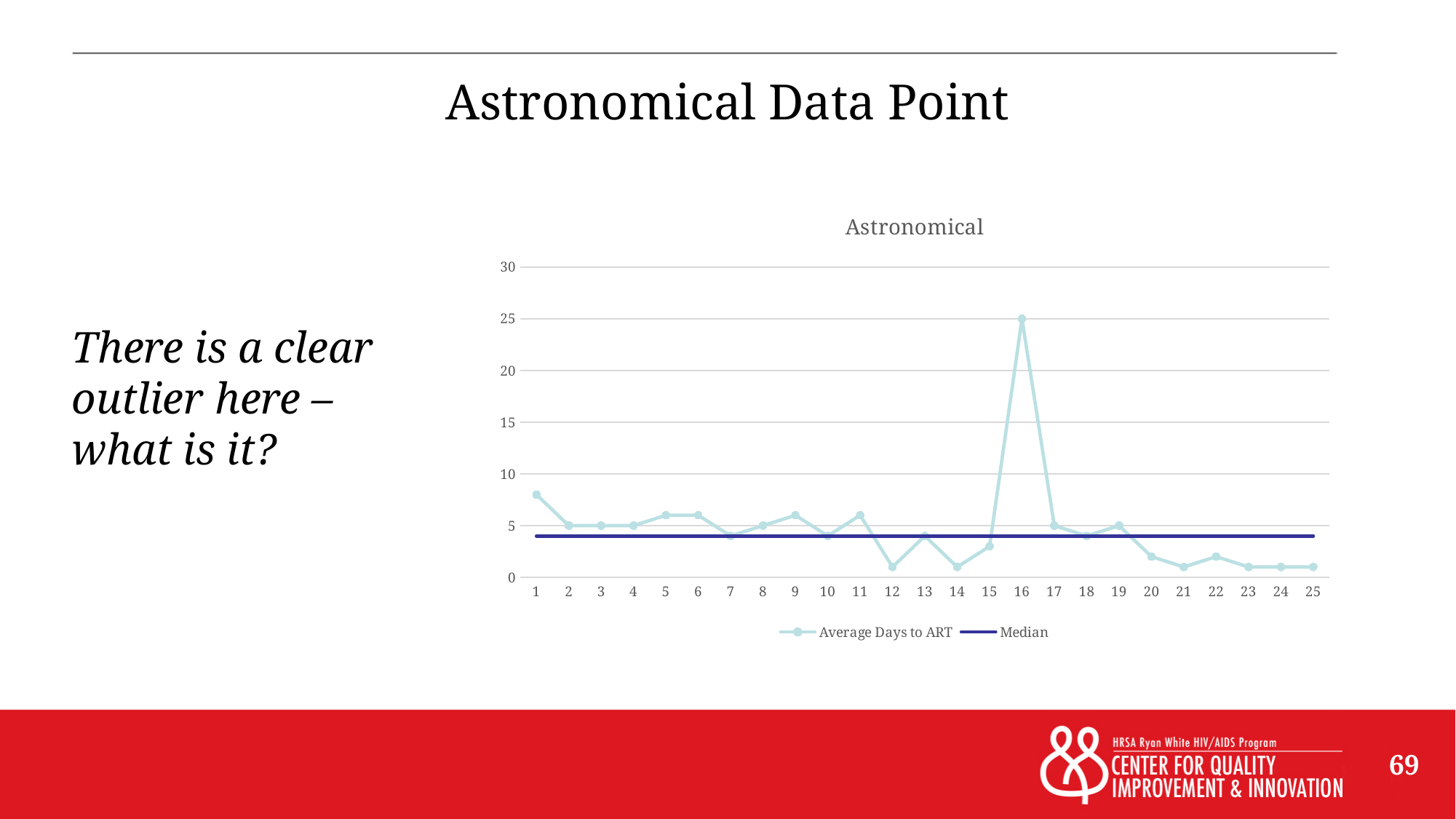
What is the value of Average Days to ART at point 16? 25 How many points are plotted along the x axis for Average Days to ART? 25 What kind of chart is shown on the slide? line chart What is the title of the chart? Astronomical What is the value of Average Days to ART at point 2? 5 At which x-axis point is Average Days to ART highest? 16 Is the value of Average Days to ART at point 1 greater or less than 5? greater Is the Median line greater or less than 5? less How many series does the legend list? 2 Does Average Days to ART rise or fall from point 16 to point 17? fall Which is larger, Average Days to ART at point 1 or at point 25? point 1 Is the value of Average Days to ART at point 12 greater or less than 5? less